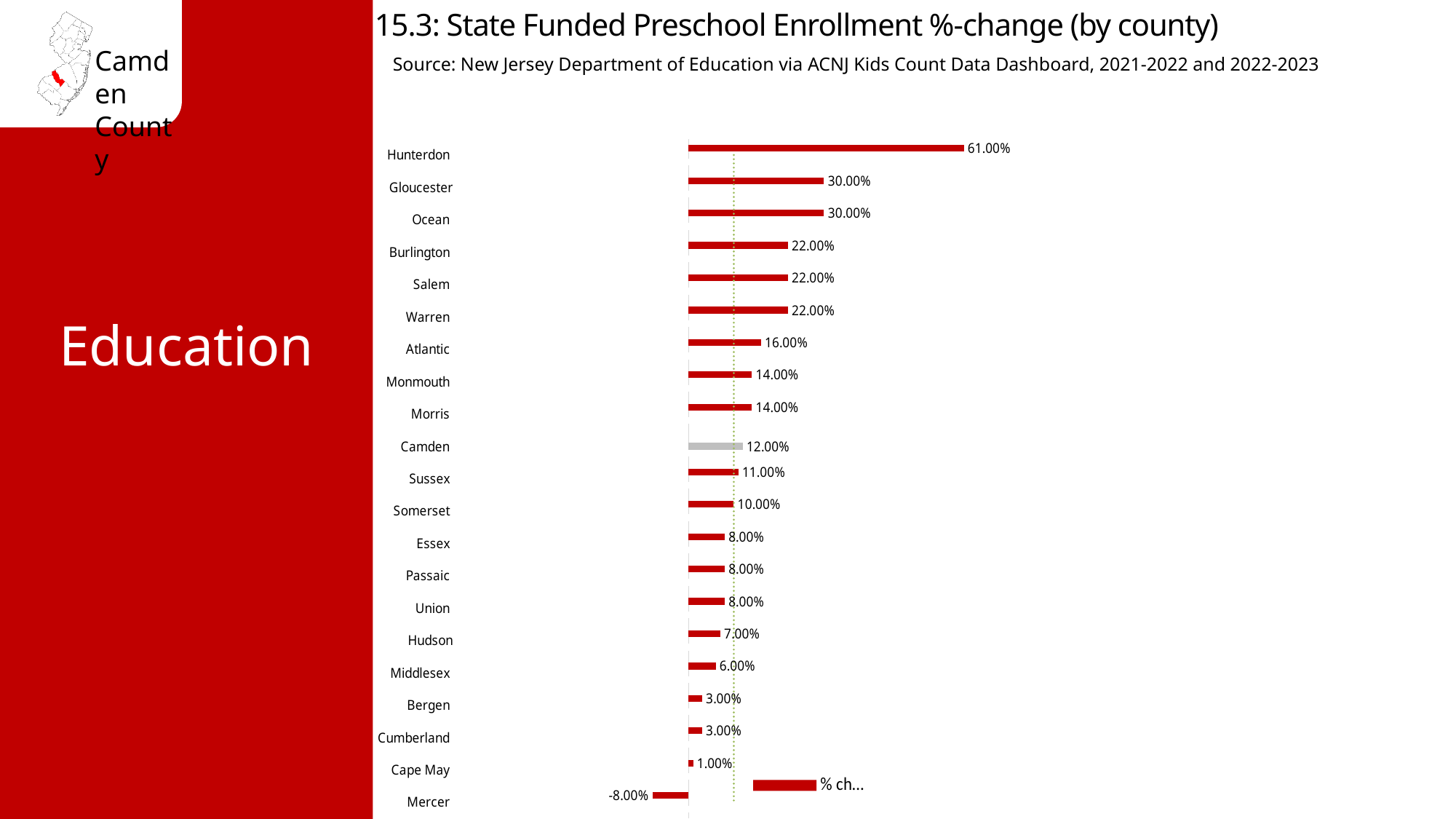
What is the difference between the values for Hunterdon and Gloucester? 31.00% Which county has the lowest value? Mercer Which county's bar is coloured grey instead of red? Camden What is the value for Atlantic? 16.00% What is the value for Mercer? -8.00% Which is larger, the value for Burlington or the value for Monmouth? Burlington Which county has the highest value? Hunterdon What is the value for Hunterdon? 61.00% What kind of chart is shown on the slide? Bar chart What is the difference between the values for Camden and Cape May? 11.00% How many counties are shown in the chart? 21 What is the value for Camden? 12.00%